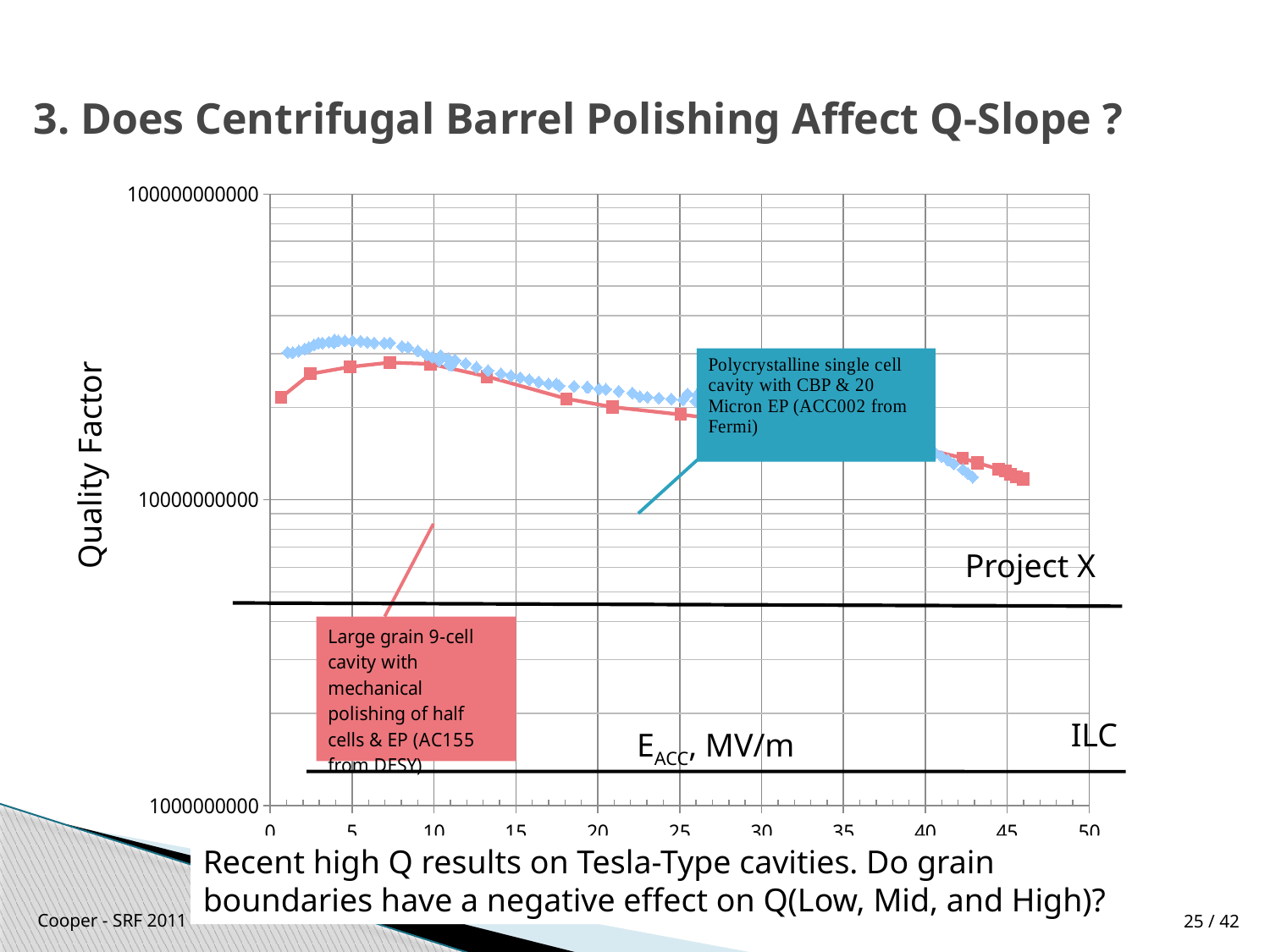
Beyond 10 MV/m, does the Quality Factor of the red-square series (AC155 from DESY) rise or fall as E_ACC increases? fall What is the lowest value shown on the Quality Factor axis? 1000000000 Is the Quality Factor of the blue-diamond series (ACC002 from Fermi) at 5 MV/m greater or less than 10000000000? greater What is the highest value shown on the x axis (E_ACC, MV/m)? 50 How many data series are plotted on the chart? 2 At 5 MV/m, which series has the higher Quality Factor: the blue-diamond series (ACC002 from Fermi) or the red-square series (AC155 from DESY)? blue-diamond series (ACC002 from Fermi) What kind of chart is shown on the slide? line chart What is the label of the vertical axis? Quality Factor Beyond 10 MV/m, does the Quality Factor of the blue-diamond series (ACC002 from Fermi) rise or fall as E_ACC increases? fall Is the Quality Factor of the red-square series (AC155 from DESY) at 45 MV/m greater or less than 10000000000? greater Is the Quality Factor of the red-square series (AC155 from DESY) at 25 MV/m greater or less than 100000000000? less